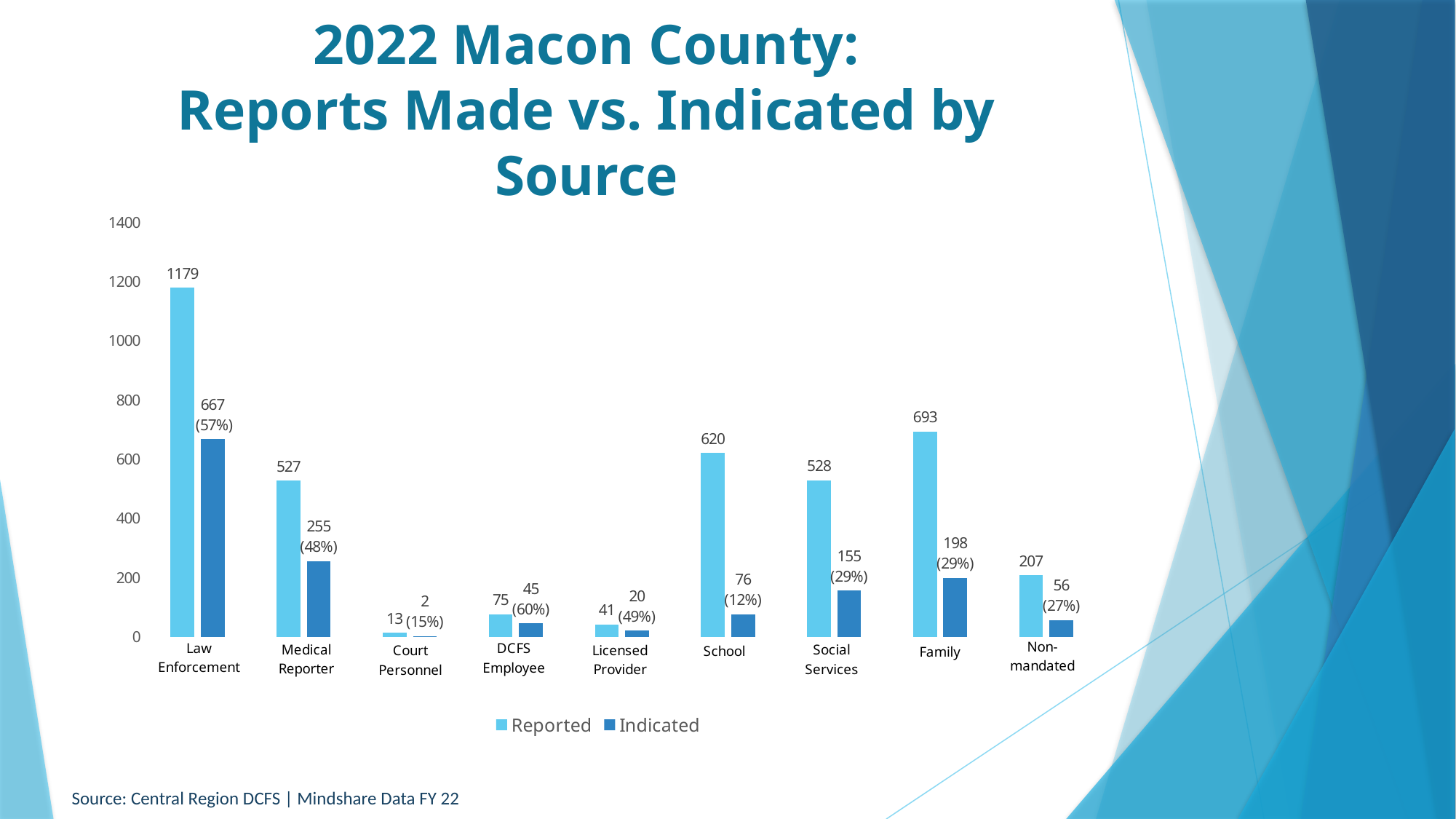
How many series does the legend list? 2 What is the Reported value for Law Enforcement? 1179 What is the difference between the Reported and Indicated values for Medical Reporter? 272 What is the source cited at the bottom of the slide? Central Region DCFS | Mindshare Data FY 22 Which source has the highest Reported value? Law Enforcement Which source has the lowest Indicated value? Court Personnel What is the Indicated value for School? 76 Which is larger, the Reported value for School or the Reported value for Family? Family Is the Reported value for Social Services greater or less than 400? greater What kind of chart is shown on the slide? Bar chart How many source categories are shown on the x axis? 9 What percentage is shown next to the Indicated value for DCFS Employee? 60%